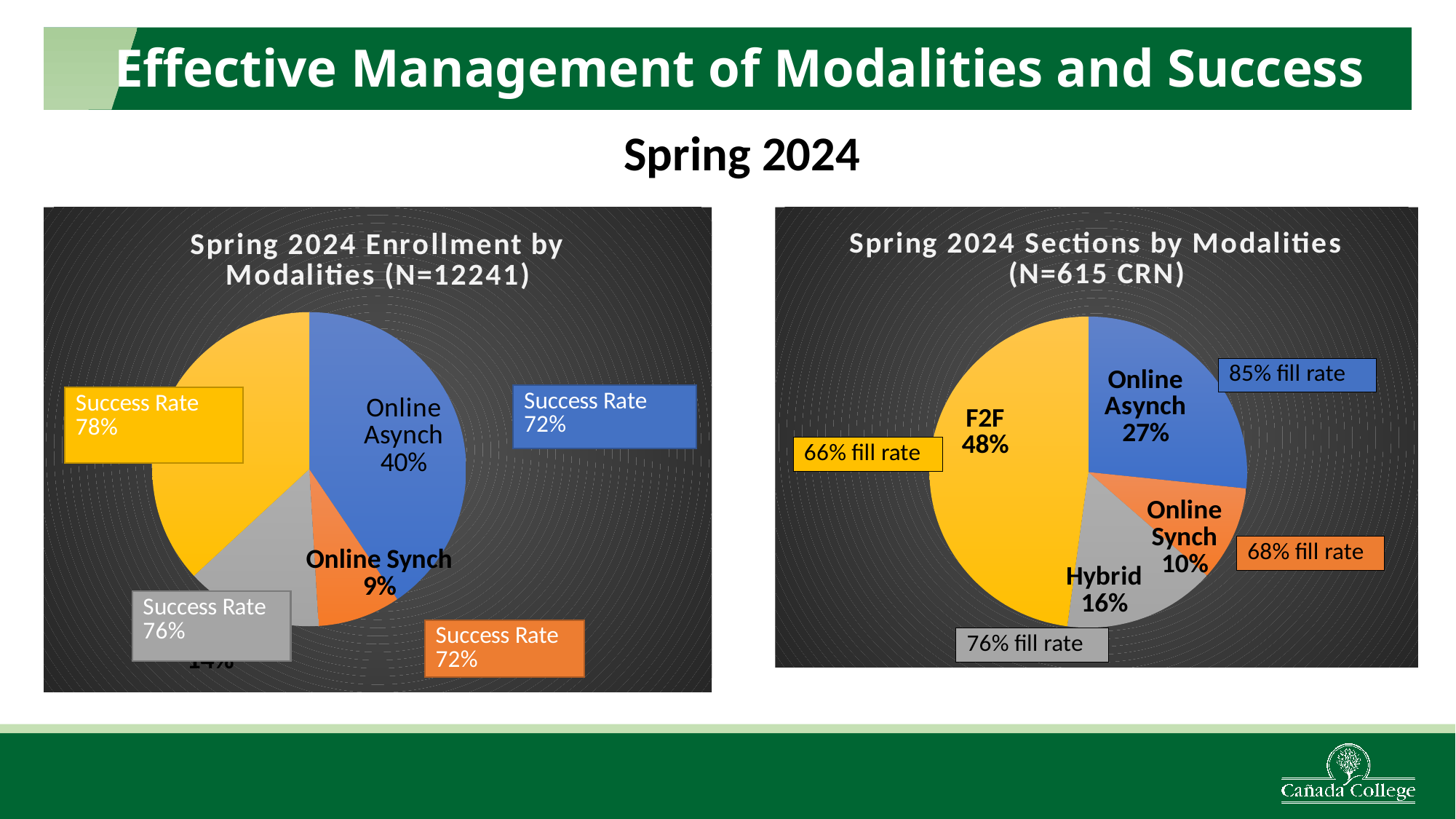
In the Spring 2024 Sections by Modalities chart, what share of sections is Online Asynch? 27% What is the N value given in the title of the Spring 2024 Enrollment by Modalities chart? N=12241 In the Spring 2024 Sections by Modalities chart, what fill rate is shown for the Online Asynch slice? 85% fill rate What kind of chart is the Spring 2024 Enrollment by Modalities chart? Pie chart In the Spring 2024 Sections by Modalities chart, which modality has the largest slice? F2F In the Spring 2024 Enrollment by Modalities chart, what share of enrollment is Online Asynch? 40% In the Spring 2024 Sections by Modalities chart, which modality has the smallest slice? Online Synch In the Spring 2024 Sections by Modalities chart, which slice is larger, Hybrid or Online Synch? Hybrid In the Spring 2024 Sections by Modalities chart, what share of sections is F2F? 48% How many slices does the Spring 2024 Sections by Modalities pie chart have? 4 In the Spring 2024 Sections by Modalities chart, how many percentage points larger is the F2F share than the Hybrid share? 32 percentage points